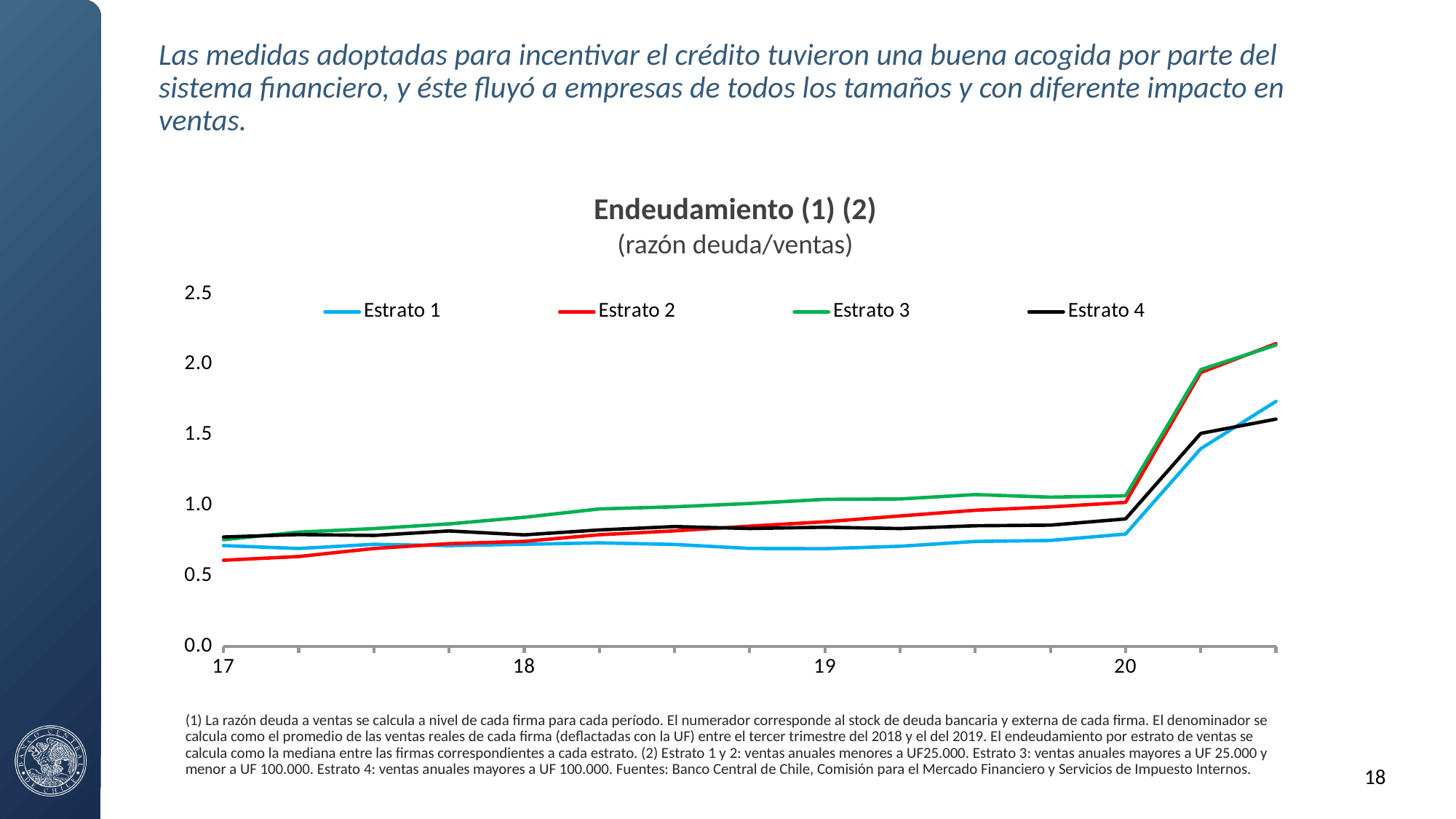
Which series has the lowest value at the start of the series (17)? Estrato 2 At the start of the series (17), which is higher, Estrato 3 or Estrato 2? Estrato 3 Is the value for Estrato 1 at the end of the series greater or less than 1.5? greater Is the value for Estrato 3 at the end of the series greater or less than 1.5? greater What kind of chart is shown on the slide? line chart How many year labels are shown on the x axis? 4 What is the title of the chart? Endeudamiento (1) (2) Which series has the lowest value at the end of the series? Estrato 4 How many series does the legend list? 4 Is the value for Estrato 2 at the start of the series (17) greater or less than 1.0? less Does the Estrato 2 line rise or fall overall from 17 to the end of the series? rise What unit or measure is given in the chart subtitle? razón deuda/ventas